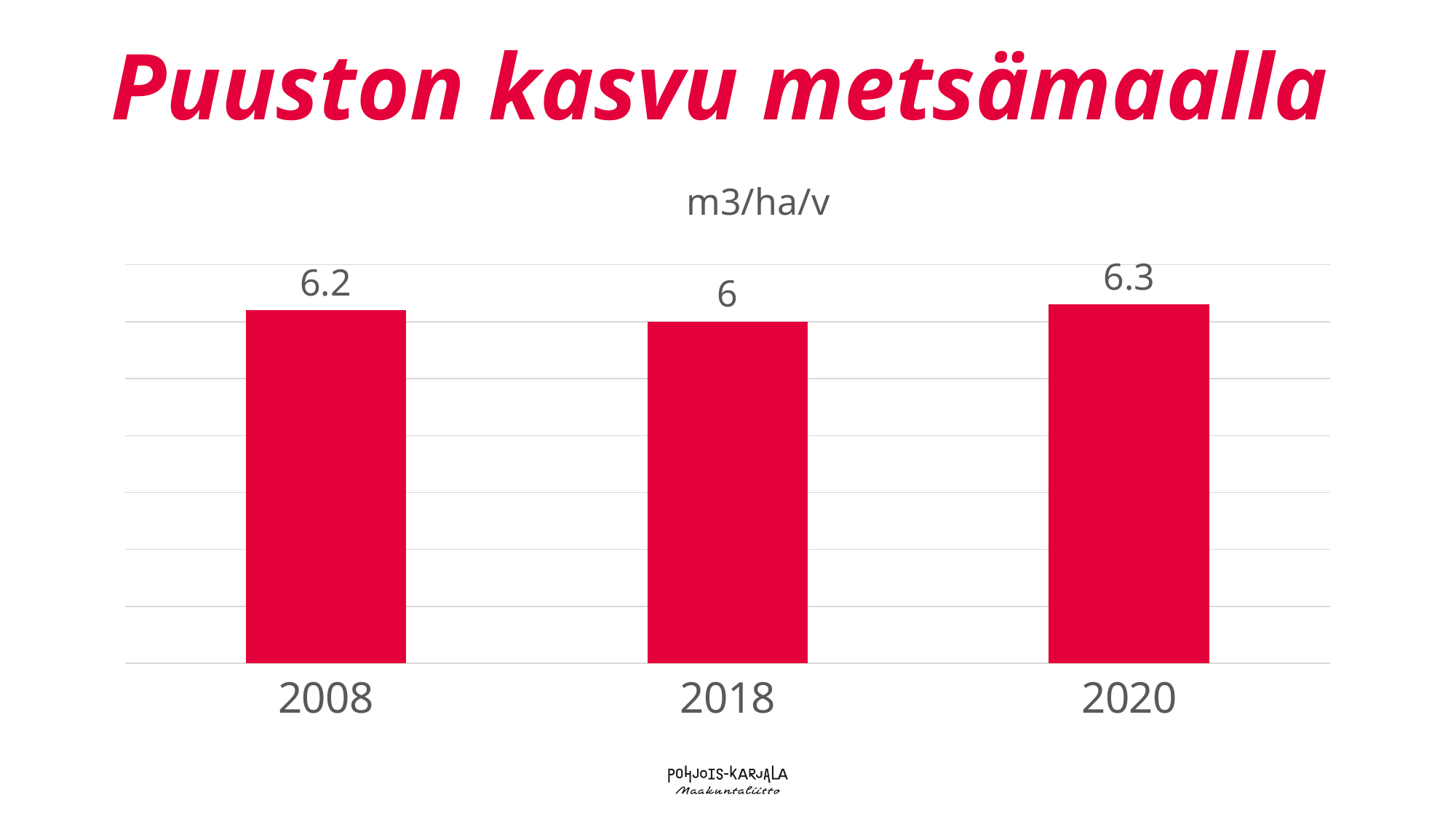
Which is larger, the value for 2008 or the value for 2020? 2020 Which year has the highest value? 2020 What is the value for 2008? 6.2 What is the title of the chart? m3/ha/v What kind of chart is shown on the slide? bar chart Which year has the lowest value? 2018 What is the difference between the values for 2008 and 2018? 0.2 Does the value rise or fall from 2008 to 2018? fall How many years are shown on the chart? 3 What is the value for 2020? 6.3 What is the difference between the values for 2020 and 2018? 0.3 What is the value for 2018? 6